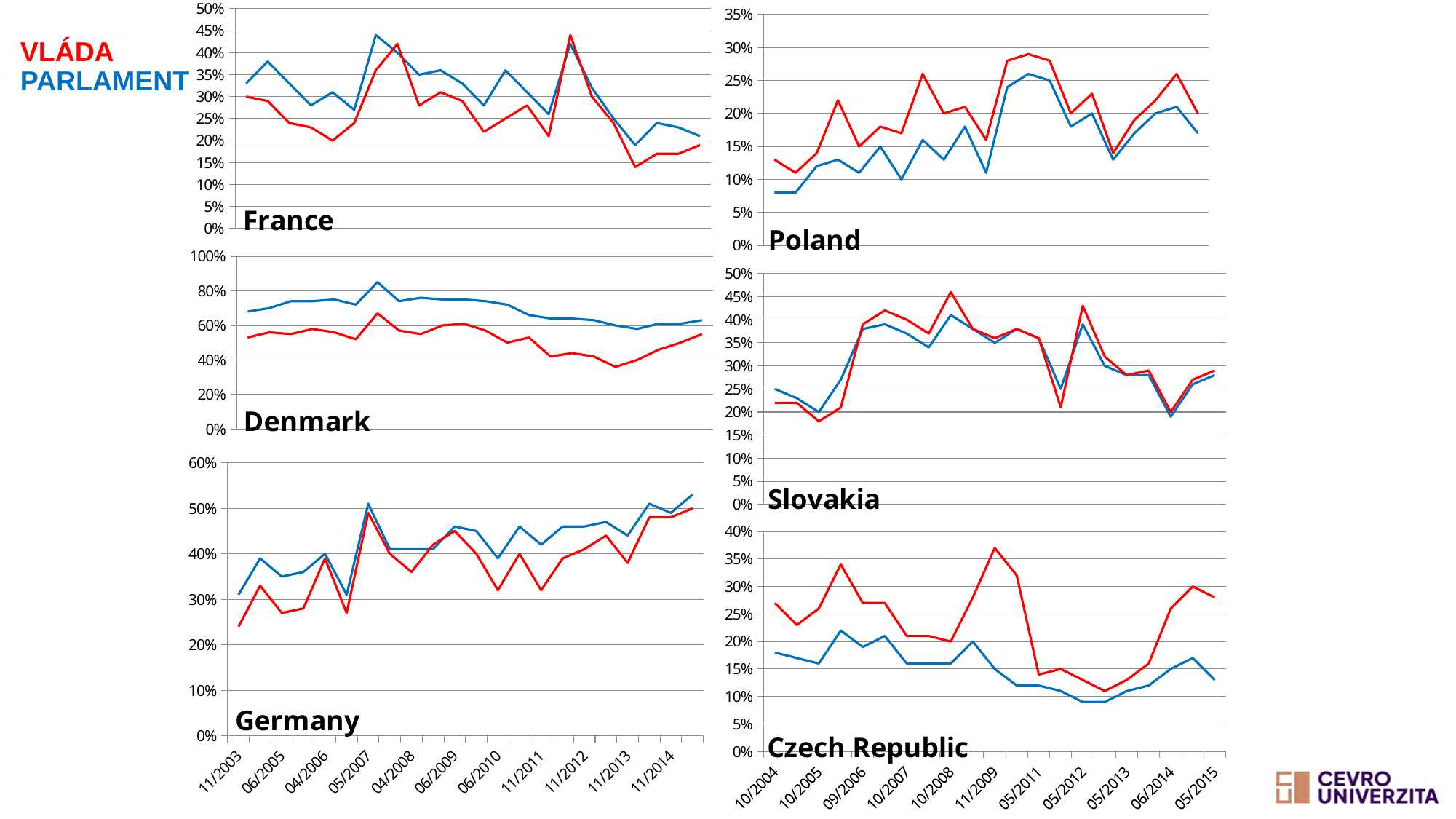
In the Denmark chart, which series has the higher values, VLÁDA or PARLAMENT? PARLAMENT In the Denmark chart, is the first value of the PARLAMENT line greater or less than 60%? greater In the Germany chart, is the PARLAMENT value at 11/2003 greater or less than 40%? less What colour is the VLÁDA line in the charts? red In the Poland chart, is the highest value of the VLÁDA line greater or less than 25%? greater What kind of chart is the France chart? line chart How many country charts are shown on the slide? 6 In the Czech Republic chart, which series has the higher values, VLÁDA or PARLAMENT? VLÁDA In the Germany chart, does the PARLAMENT line overall rise or fall from 11/2003 to the last point? rise How many series does the legend list? 2